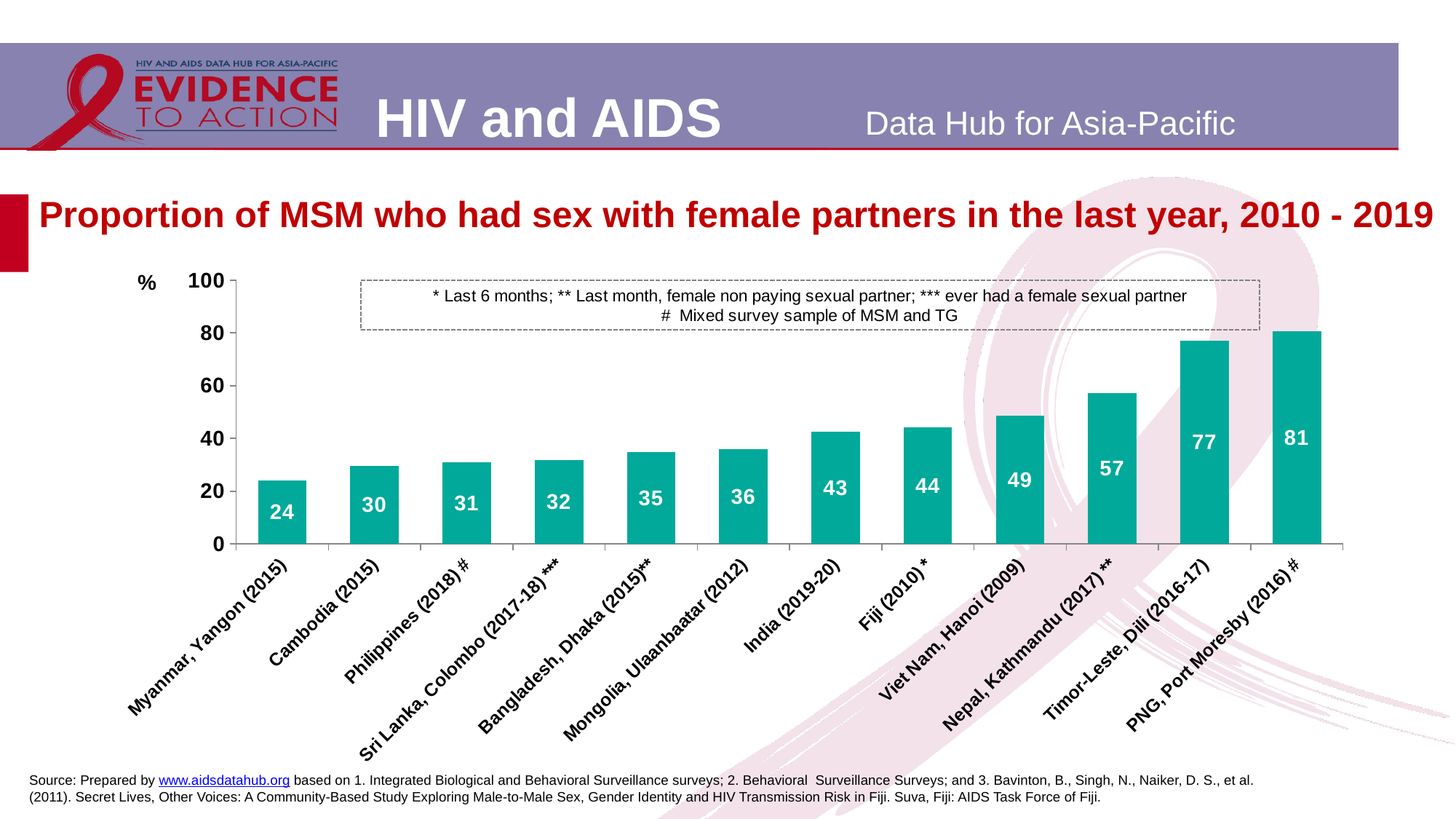
How many categories are shown on the x axis? 12 What is the value for Myanmar, Yangon (2015)? 24 Do the values rise or fall from left to right along the x axis? rise Which is larger, the value for Fiji (2010) or the value for Bangladesh, Dhaka (2015)? Fiji (2010) Which category has the lowest value? Myanmar, Yangon (2015) What is the difference between the values for PNG, Port Moresby (2016) and Timor-Leste, Dili (2016-17)? 4 Which category has the highest value? PNG, Port Moresby (2016) Is the value for Mongolia, Ulaanbaatar (2012) greater or less than 40? less What is the value for Nepal, Kathmandu (2017)? 57 What is the value for India (2019-20)? 43 What is the difference between the values for Viet Nam, Hanoi (2009) and Cambodia (2015)? 19 What kind of chart is shown on the slide? bar chart